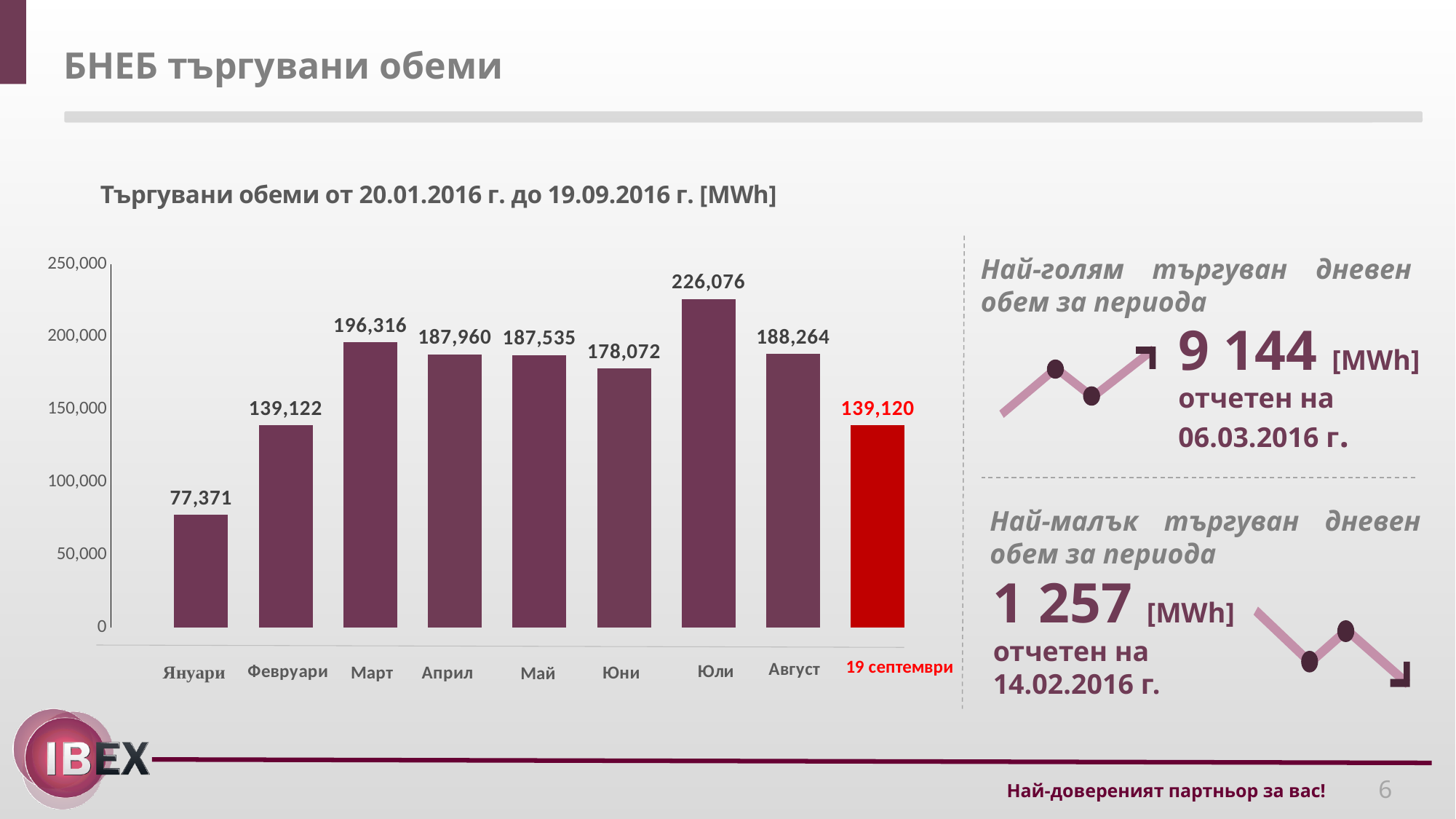
What is the value shown for 19 септември? 139,120 Which category has the lowest traded volume? Януари How many categories are shown on the x axis of the chart? 9 What is the traded volume for Юли? 226,076 What is the difference between the traded volumes for Юли and Януари? 148,705 Do the traded volumes rise or fall from Януари to Март? rise Which month has the highest traded volume? Юли What is the traded volume for Януари? 77,371 Which is larger, the traded volume for Март or for Юни? Март What kind of chart is shown on the slide? bar chart What is the difference between the traded volumes for Март and Февруари? 57,194 Is the value for Юни greater or less than 150,000? greater